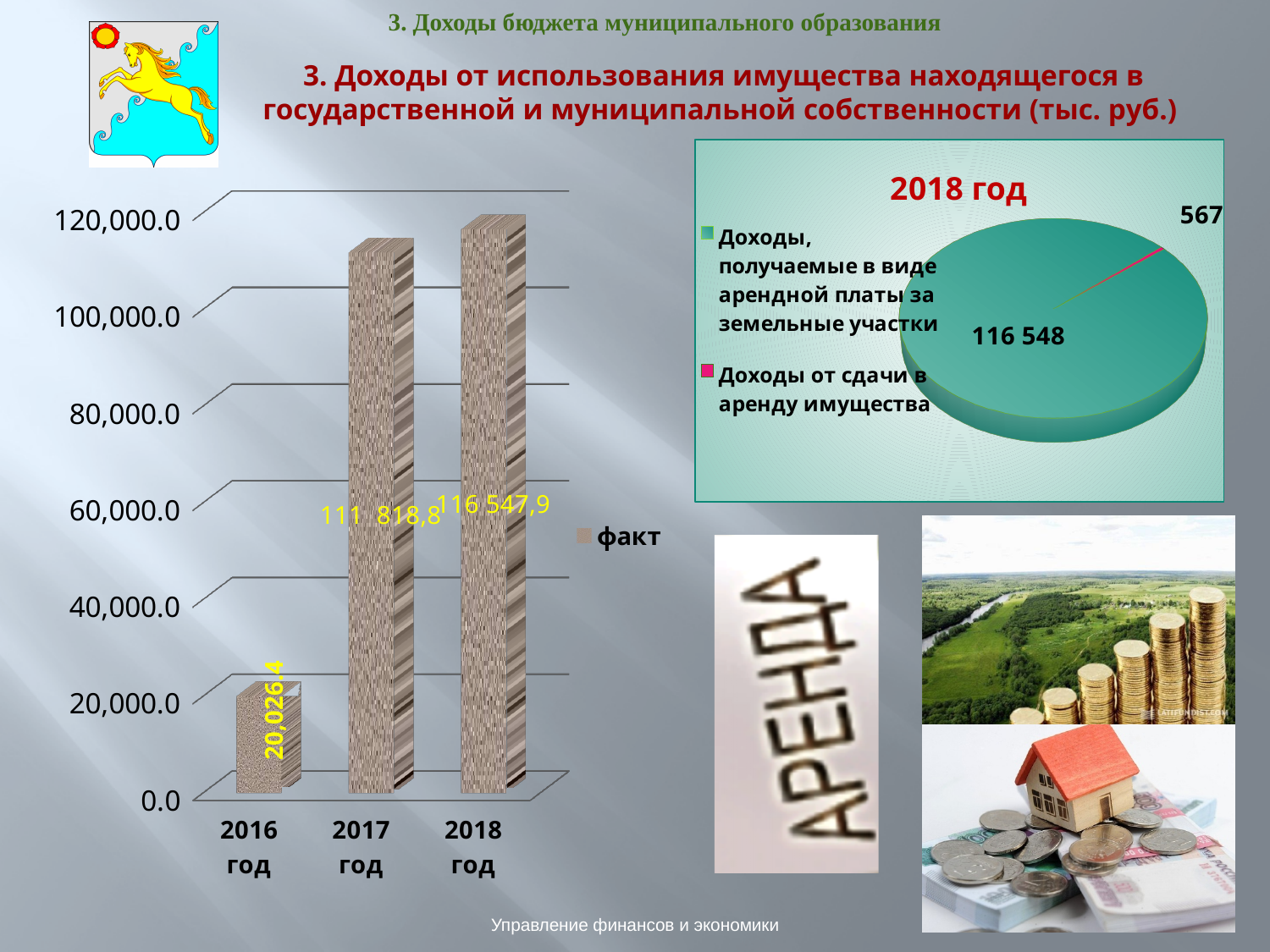
On the pie chart titled '2018 год', what is the value for Доходы, получаемые в виде арендной платы за земельные участки? 116 548 On the pie chart titled '2018 год', what is the value for Доходы от сдачи в аренду имущества? 567 On the bar chart on the left, how many years are shown on the x axis? 3 On the bar chart on the left, what is the value for 2018 год? 116 547,9 On the bar chart on the left, which year has the lowest value? 2016 год On the bar chart on the left, do the values rise or fall from 2016 to 2018? rise On the bar chart on the left, what is the value for 2017 год? 111 818,8 What kind of chart is the chart titled '2018 год'? pie chart On the bar chart on the left, which year has the highest value? 2018 год On the bar chart on the left, is the value for 2017 год greater or less than 100,000.0? greater On the bar chart on the left, what is the name of the series in the legend? факт On the bar chart on the left, what is the value for 2016 год? 20,026.4